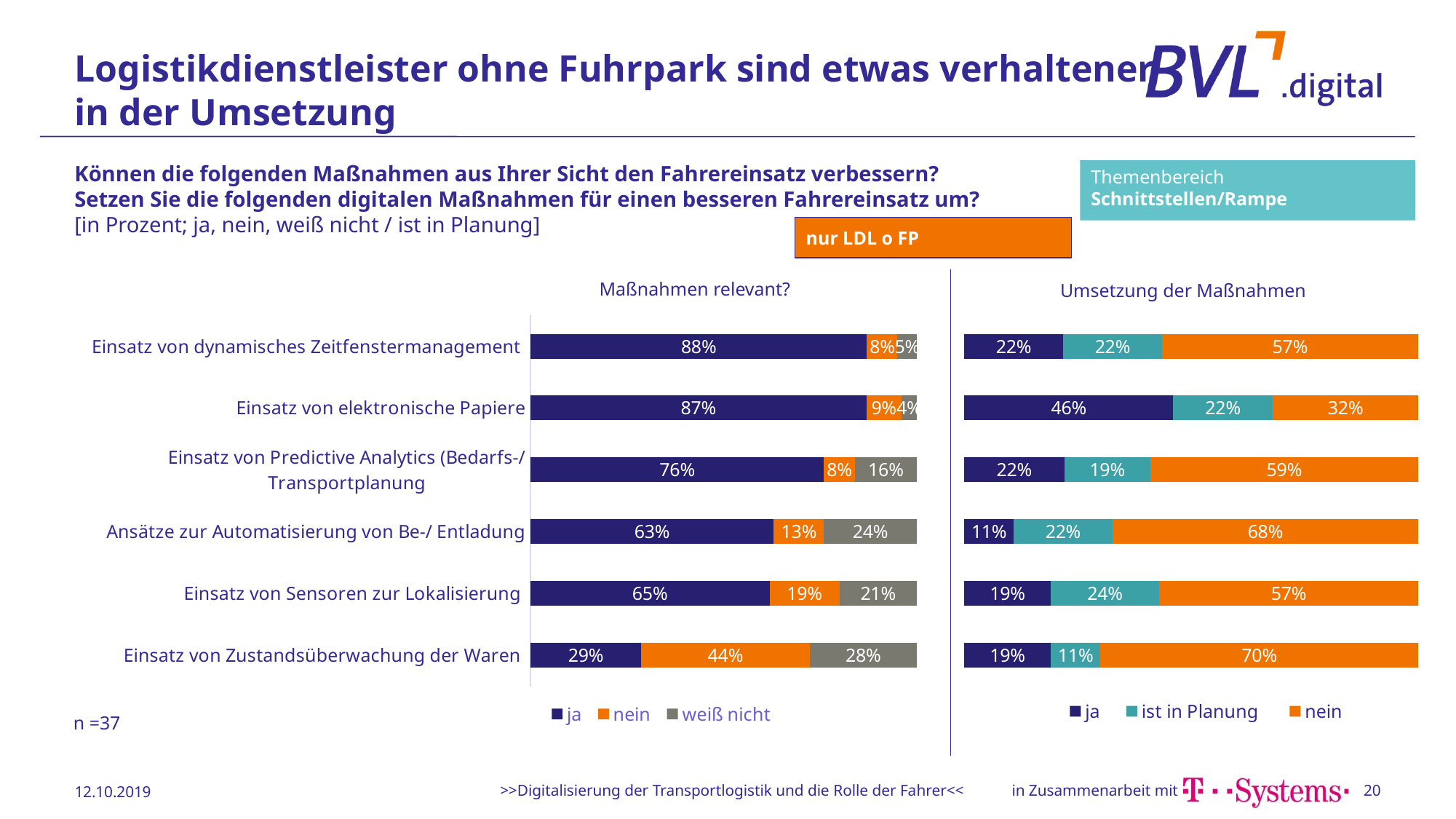
What kind of chart is the 'Umsetzung der Maßnahmen' chart? Stacked bar chart In the 'Umsetzung der Maßnahmen' chart, which is larger: the 'nein' value for 'Ansätze zur Automatisierung von Be-/ Entladung' or the 'nein' value for 'Einsatz von Predictive Analytics (Bedarfs-/ Transportplanung'? Ansätze zur Automatisierung von Be-/ Entladung How many categories are shown in the 'Maßnahmen relevant?' chart? 6 In the 'Umsetzung der Maßnahmen' chart, which category has the highest 'ja' value? Einsatz von elektronische Papiere How many series does the legend of the 'Umsetzung der Maßnahmen' chart list? 3 In the 'Maßnahmen relevant?' chart, what is the 'ja' value for 'Einsatz von dynamisches Zeitfenstermanagement'? 88% In the 'Umsetzung der Maßnahmen' chart, what is the 'nein' value for 'Einsatz von Zustandsüberwachung der Waren'? 70% In the 'Maßnahmen relevant?' chart, what is the difference between the 'nein' value for 'Einsatz von Zustandsüberwachung der Waren' and the 'nein' value for 'Einsatz von Sensoren zur Lokalisierung'? 25% In the 'Maßnahmen relevant?' chart, what is the 'weiß nicht' value for 'Einsatz von Predictive Analytics (Bedarfs-/ Transportplanung'? 16% In the 'Umsetzung der Maßnahmen' chart, what is the 'ist in Planung' value for 'Einsatz von Sensoren zur Lokalisierung'? 24% In the 'Maßnahmen relevant?' chart, which category has the lowest 'ja' value? Einsatz von Zustandsüberwachung der Waren What are the legend entries of the 'Maßnahmen relevant?' chart? ja, nein, weiß nicht